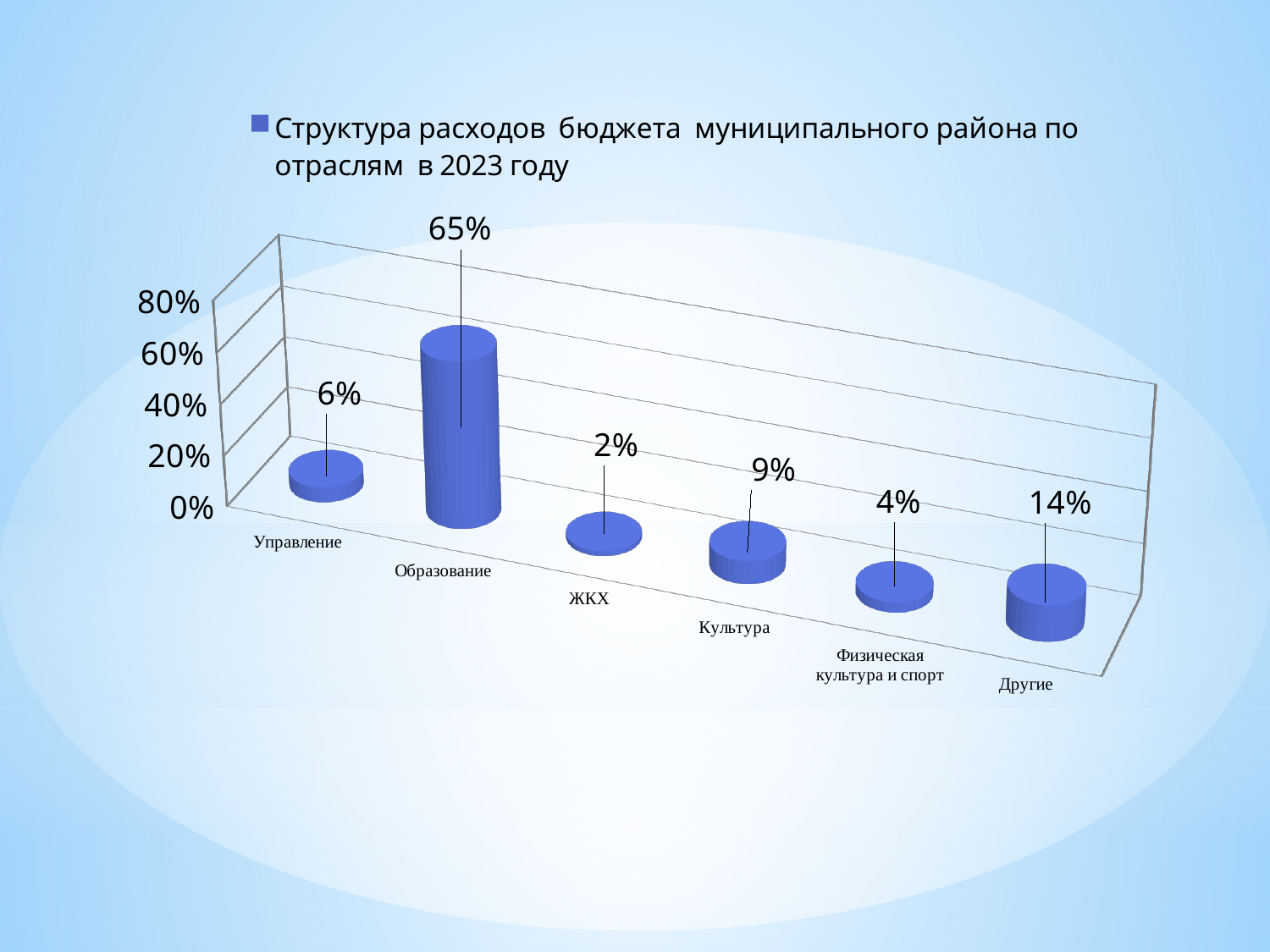
What kind of chart is shown on the slide? bar chart What is the legend entry shown above the chart? Структура расходов бюджета муниципального района по отраслям в 2023 году What is the value for Управление? 6% Which category has the highest value? Образование What is the value for Физическая культура и спорт? 4% Which is larger, the value for Культура or the value for Управление? Культура How many categories are shown on the chart? 6 Is the value for Образование greater or less than 60%? greater What is the value for Другие? 14% Which category has the lowest value? ЖКХ What is the value for Образование? 65% What is the difference between the values for Образование and Другие? 51%